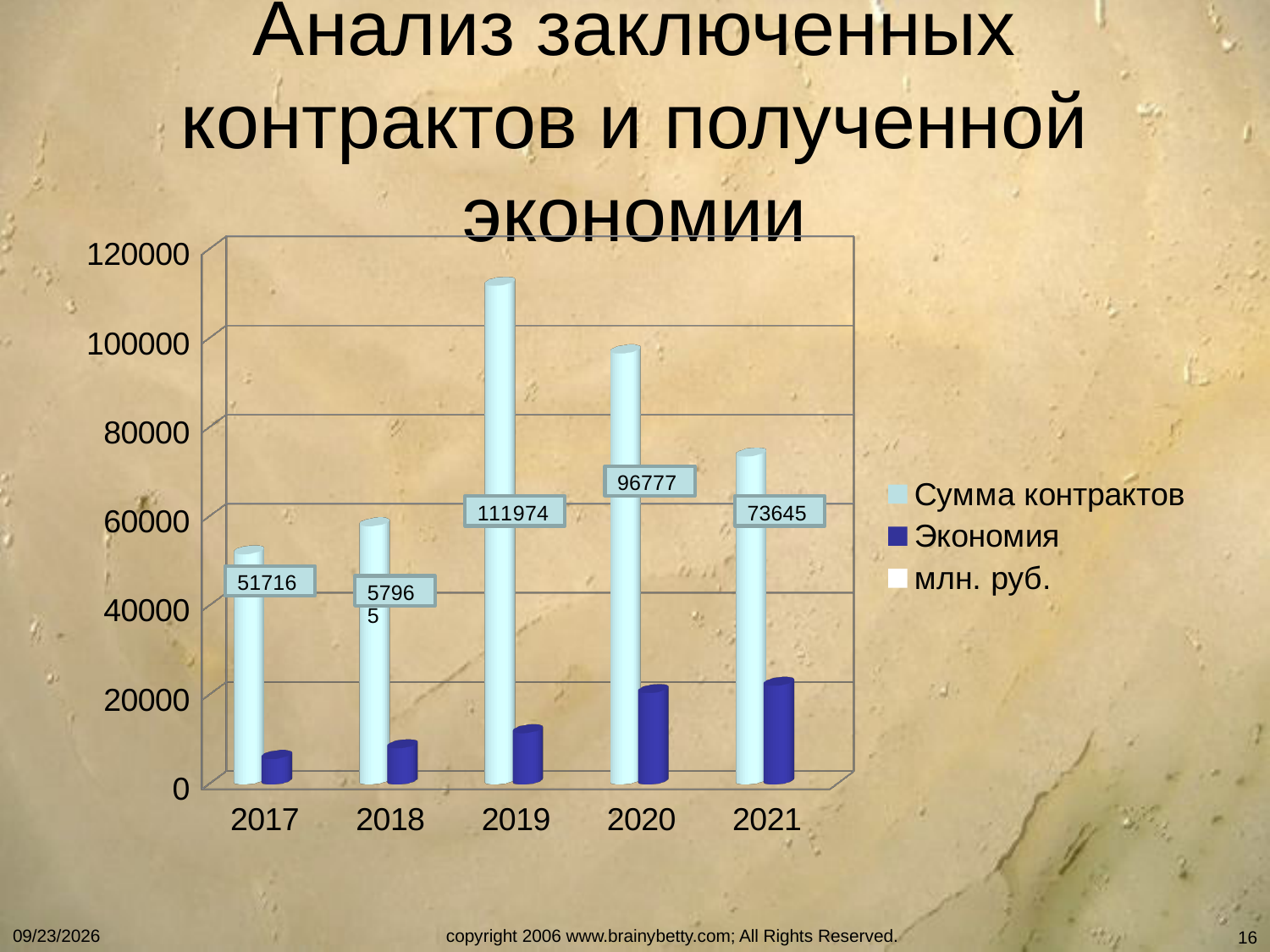
How many years are shown on the x axis? 5 What is the value of Сумма контрактов for 2020? 96777 What is the difference between Сумма контрактов in 2019 and 2020? 15197 Is the Экономия value for 2019 greater or less than 20000? less Which year has the larger Сумма контрактов, 2020 or 2021? 2020 What is the value of Сумма контрактов for 2021? 73645 What is the value of Сумма контрактов for 2017? 51716 Which year has the highest Сумма контрактов? 2019 What kind of chart is shown on the slide? bar chart Which year has the lowest Сумма контрактов? 2017 What is the value of Сумма контрактов for 2019? 111974 Which year has the lowest Экономия? 2017